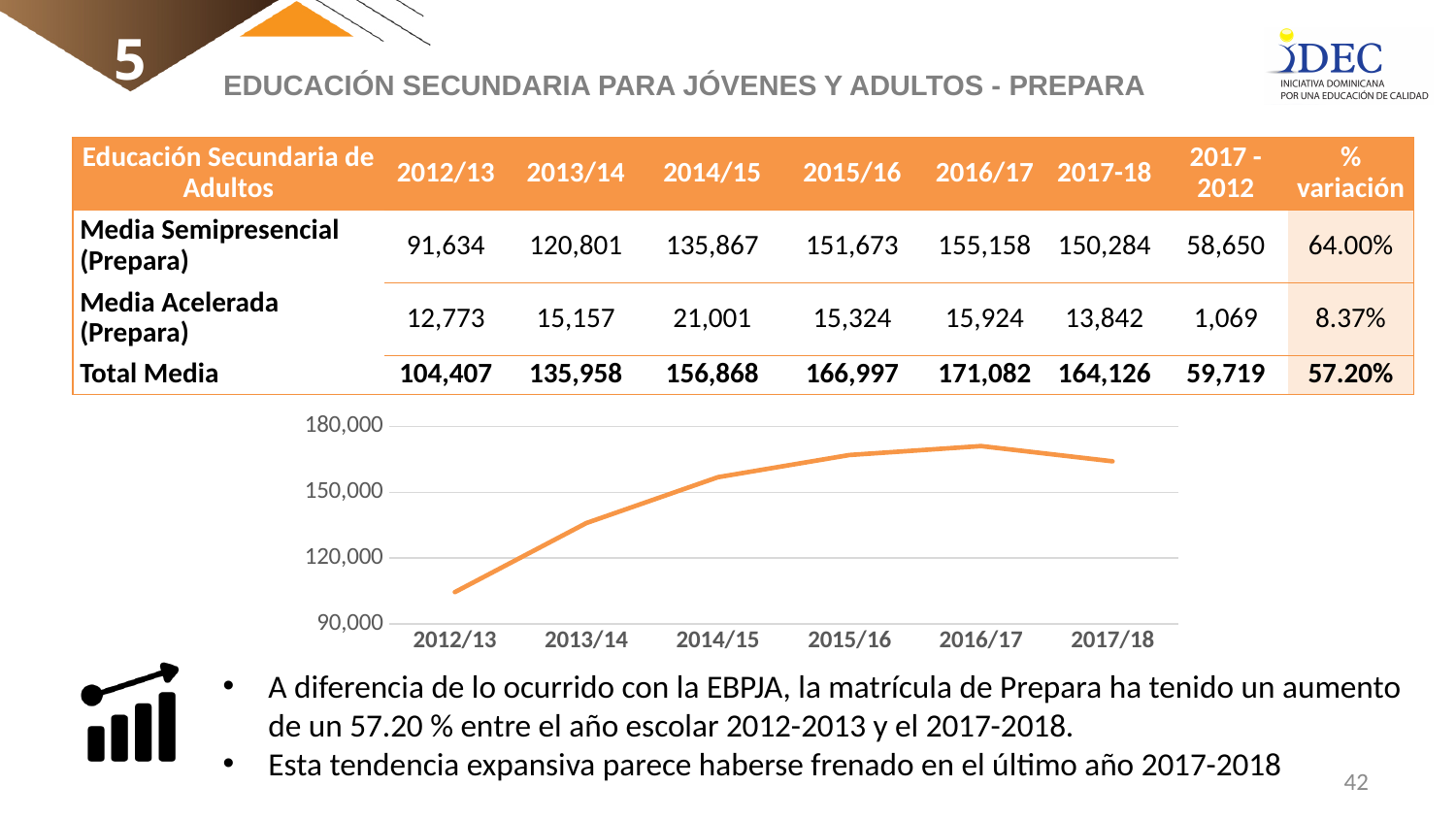
Is the value for 2017/18 greater or less than 150,000? greater How many school years are plotted along the x axis of the chart? 6 How does the plotted value change from 2012/13 to 2016/17? It rises Which school year has the lowest value on the chart? 2012/13 Does the line rise or fall between 2016/17 and 2017/18? falls Is the value for 2014/15 greater or less than 150,000? greater What kind of chart is shown on the slide? line chart What is the lowest value shown on the chart's vertical axis? 90,000 Which is larger on the chart, the value for 2013/14 or the value for 2015/16? 2015/16 Is the value for 2012/13 greater or less than 120,000? less Which school year has the highest value on the chart? 2016/17 According to the Total Media row of the table, what is the value plotted for 2016/17? 171,082